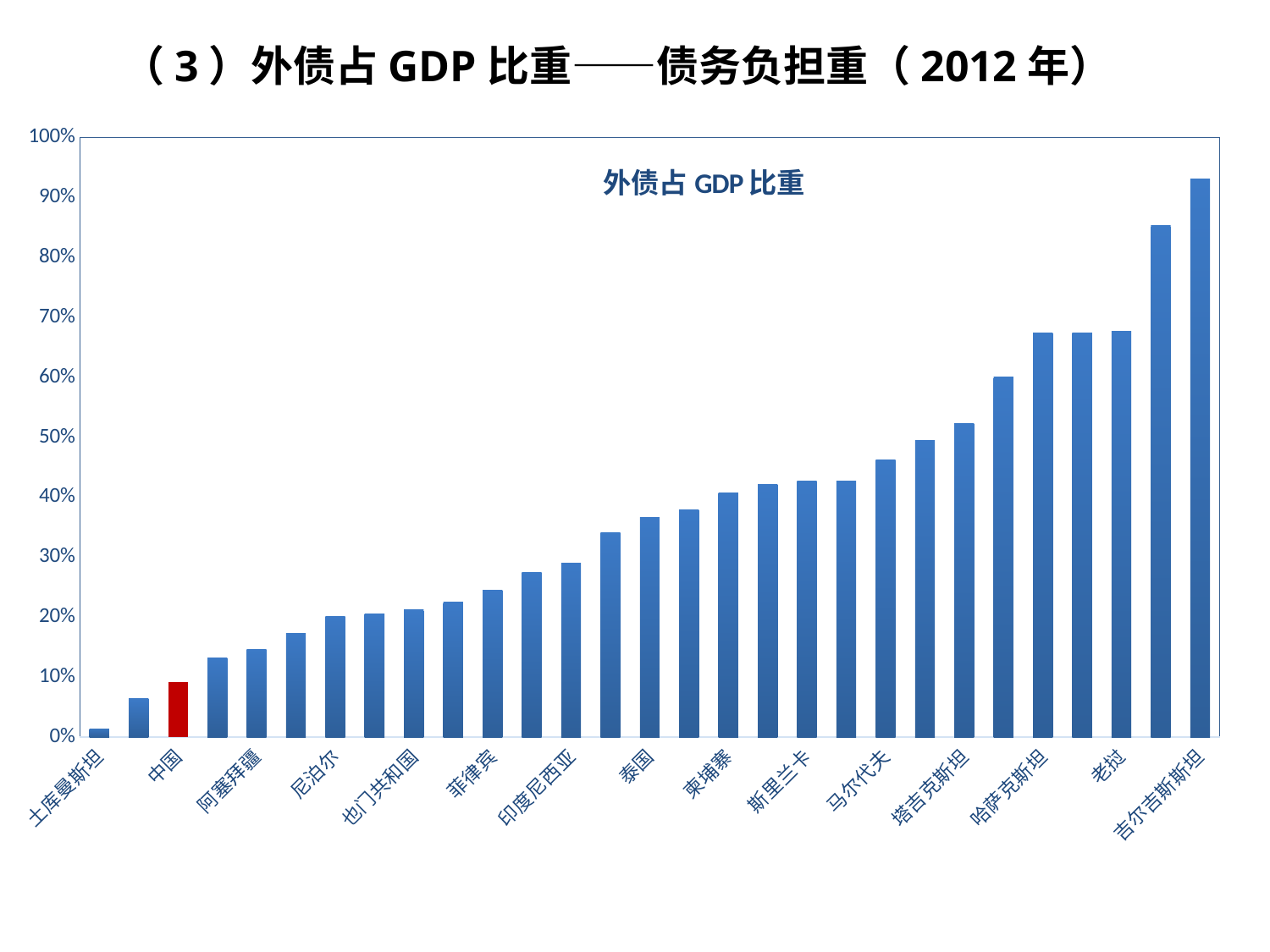
Is the value for 老挝 greater or less than 60%? greater Is the value for 吉尔吉斯斯坦 greater or less than 90%? greater Is the value for 中国 greater or less than 20%? less What is the title of the chart? 外债占 GDP 比重 Do the values rise or fall from left to right along the x axis? rise What kind of chart is shown on the slide? bar chart Which country's bar is highlighted in red? 中国 Which country has the lowest external debt to GDP ratio in the chart? 土库曼斯坦 Which has a larger external debt to GDP ratio, 老挝 or 泰国? 老挝 Which country has the highest external debt to GDP ratio in the chart? 吉尔吉斯斯坦